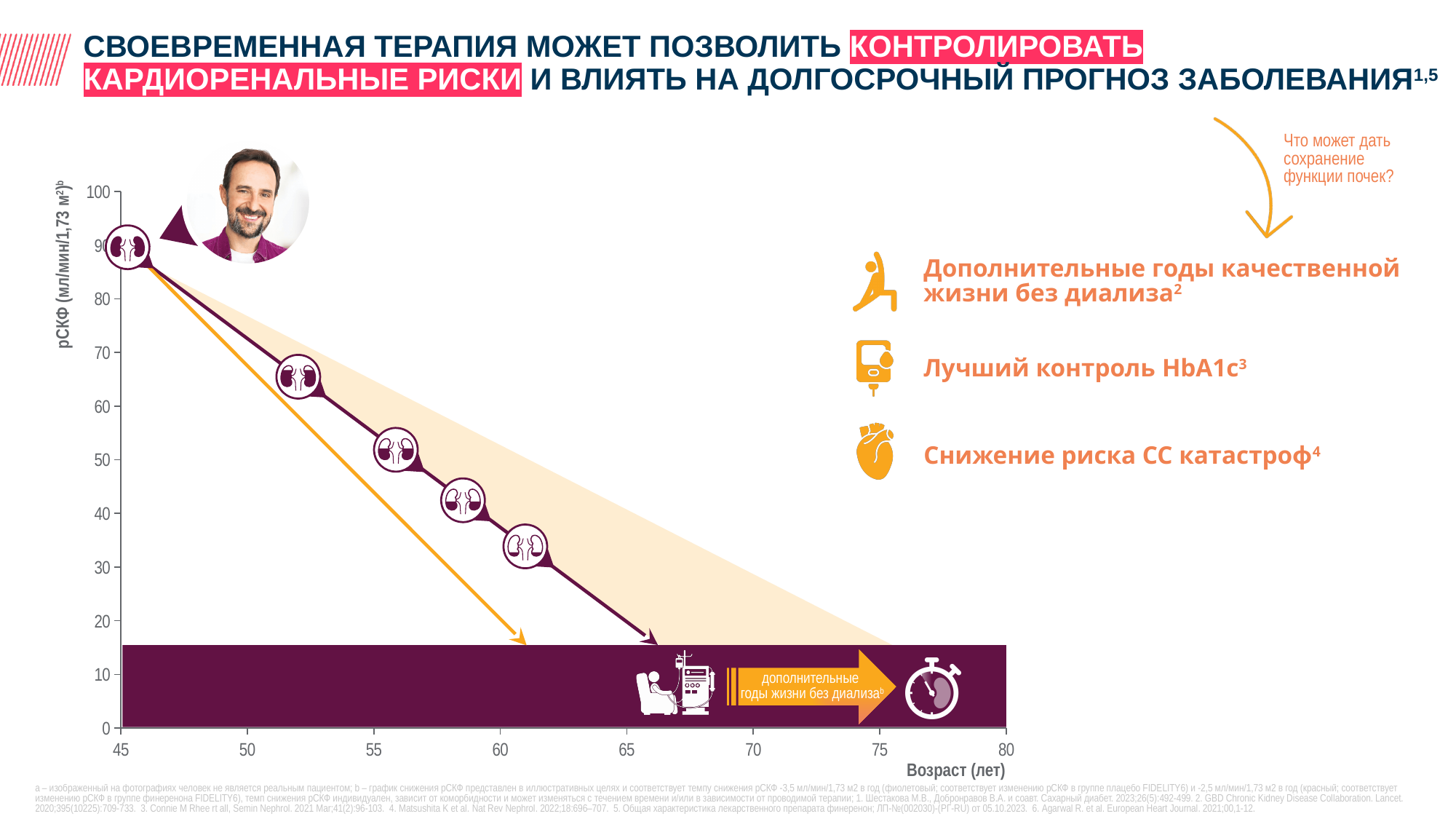
How many lines are plotted on the chart? 2 What kind of chart is shown on the slide? line chart How many kidney icon markers are placed on the chart? 5 What is the lowest age shown on the x axis? 45 Do the plotted рСКФ values rise or fall as age increases along the x axis? fall Which line, purple or orange, reaches the bottom band (below 20) at an older age? purple What is the highest value shown on the y axis? 100 Is the starting рСКФ value of the lines at age 45 greater or less than 80? greater Is the value of the purple line at age 50 greater or less than 60? greater What is the label of the y axis? рСКФ (мл/мин/1,73 м²) What is the label of the x axis? Возраст (лет) Is the value of the orange line at age 60 greater or less than 30? less